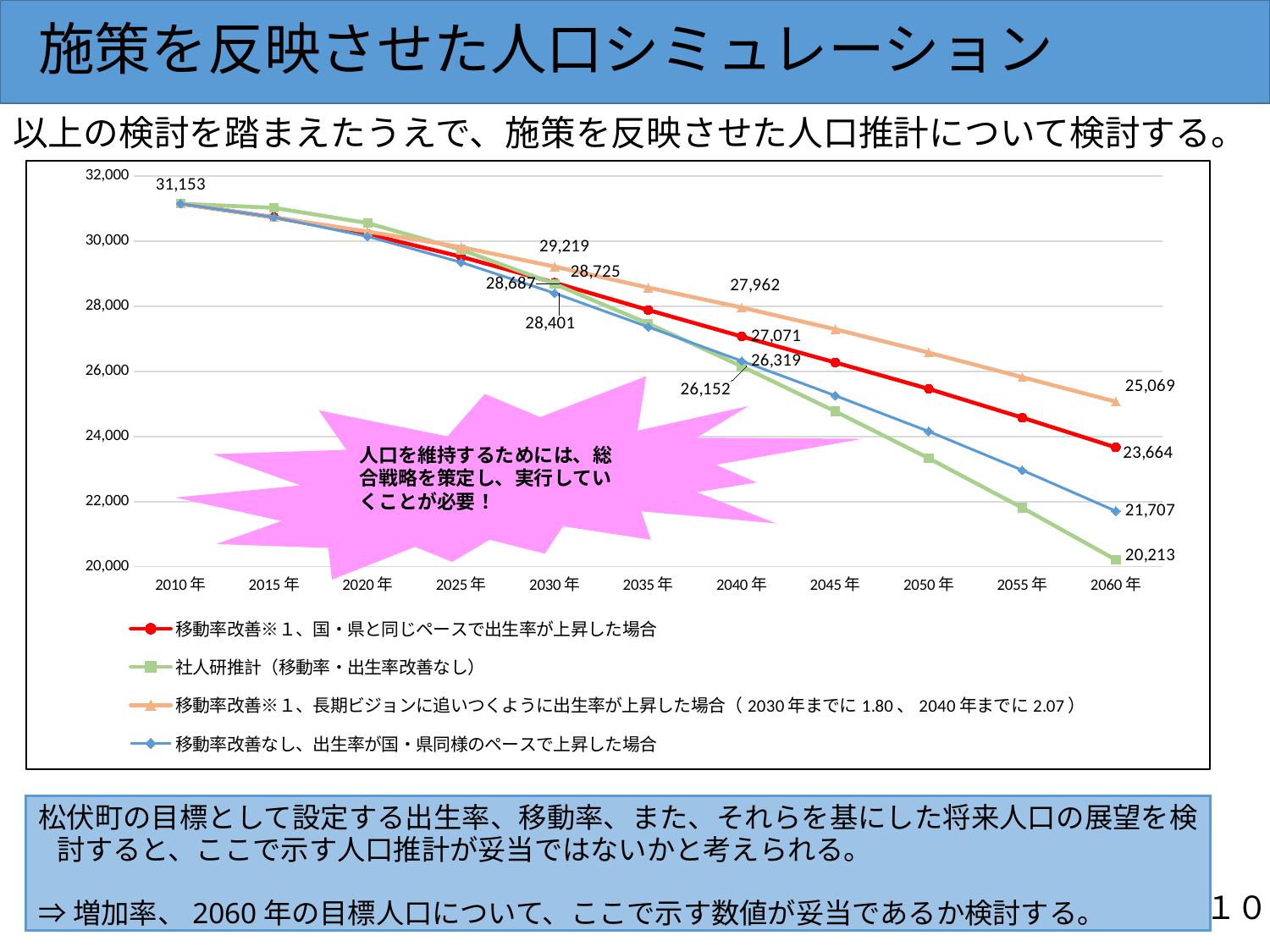
What is the 2060年 value for the 移動率改善なし、出生率が国・県同様のペースで上昇した場合 series? 21,707 Which series has the lowest value in 2060年? 社人研推計（移動率・出生率改善なし） What kind of chart is shown on the slide? Line chart What is the 2060年 value for the 移動率改善※１、長期ビジョンに追いつくように出生率が上昇した場合 series? 25,069 What is the difference between the 2060年 values of the 移動率改善※１、長期ビジョンに追いつくように出生率が上昇した場合 series and the 社人研推計 series? 4,856 What is the population value shown for 2010年? 31,153 How many series does the legend list? 4 What is the 2040年 value for the 移動率改善※１、長期ビジョンに追いつくように出生率が上昇した場合 series? 27,962 What is the 2060年 value for the 移動率改善※１、国・県と同じペースで出生率が上昇した場合 series? 23,664 What is the 2060年 value for the 社人研推計（移動率・出生率改善なし） series? 20,213 Which series has the highest value in 2060年? 移動率改善※１、長期ビジョンに追いつくように出生率が上昇した場合 Is the 2050年 value for the 社人研推計（移動率・出生率改善なし） series greater or less than 24,000? less